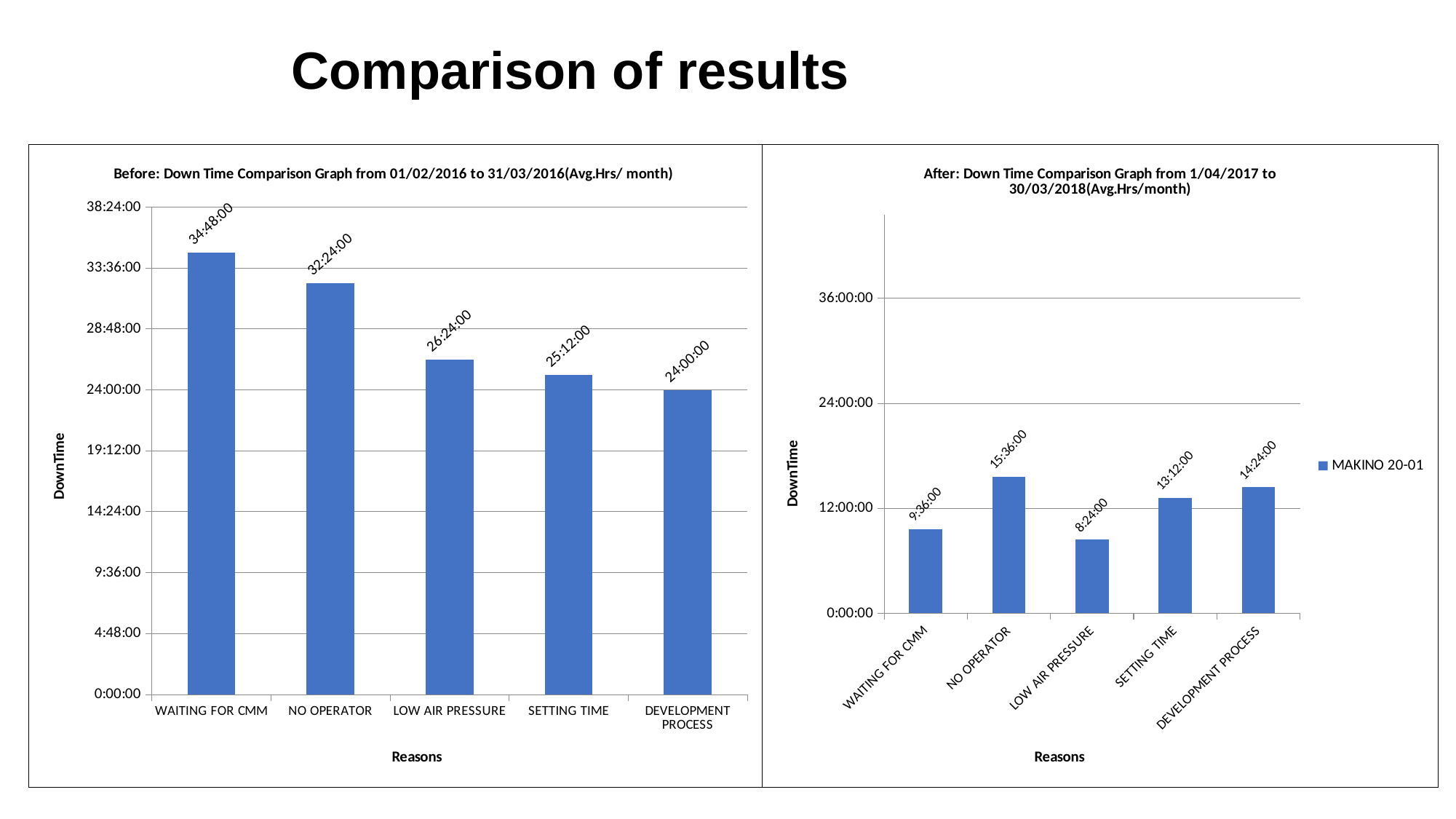
In the After chart (right), what is the down time for LOW AIR PRESSURE? 8:24:00 In the After chart (right), what is the down time for NO OPERATOR? 15:36:00 How many reasons are shown on the x axis of the Before chart (left)? 5 In the Before chart (left), what is the difference in down time between WAITING FOR CMM and NO OPERATOR? 2:24:00 In the After chart (right), which reason has the highest down time? NO OPERATOR In the After chart (right), which has the larger down time, SETTING TIME or DEVELOPMENT PROCESS? DEVELOPMENT PROCESS What type of chart is the After chart (right)? Bar chart In the Before chart (left), which reason has the highest down time? WAITING FOR CMM In the Before chart (left), what is the down time for DEVELOPMENT PROCESS? 24:00:00 In the After chart (right), which reason has the lowest down time? LOW AIR PRESSURE In the Before chart (left), what is the down time for WAITING FOR CMM? 34:48:00 What series name does the legend of the After chart (right) show? MAKINO 20-01